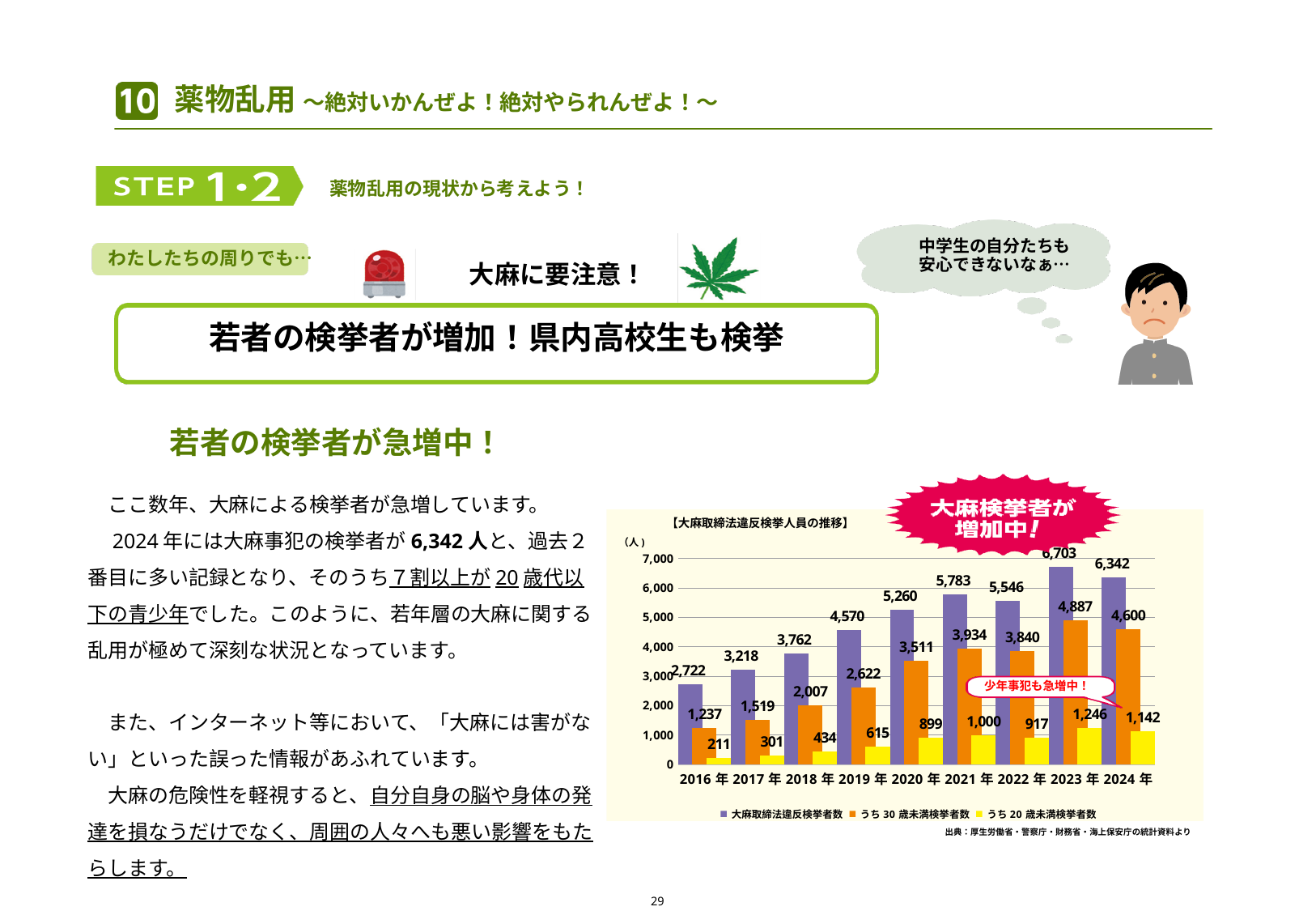
グラフで、うち20歳未満検挙者数が最も少ない年はどの年ですか？ 2016年 グラフで、2021年と2022年では、うち30歳未満検挙者数はどちらが多いですか？ 2021年 このスライドのグラフはどの種類のグラフですか？ 棒グラフ グラフで、2016年のうち20歳未満検挙者数はいくつですか？ 211 グラフで、大麻取締法違反検挙者数が最も多い年はどの年ですか？ 2023年 グラフ「大麻取締法違反検挙人員の推移」で、2024年の大麻取締法違反検挙者数は何人ですか？ 6,342 グラフの凡例にはいくつの系列がありますか？ 3 グラフには何年分のデータが示されていますか？ 9 グラフで、2023年のうち30歳未満検挙者数はいくつですか？ 4,887 グラフで、2023年と2024年の大麻取締法違反検挙者数の差は何人ですか？ 361 グラフで、2020年の大麻取締法違反検挙者数は5,000より多いですか、少ないですか？ 多い グラフで、2016年から2021年にかけて大麻取締法違反検挙者数は増加していますか、減少していますか？ 増加